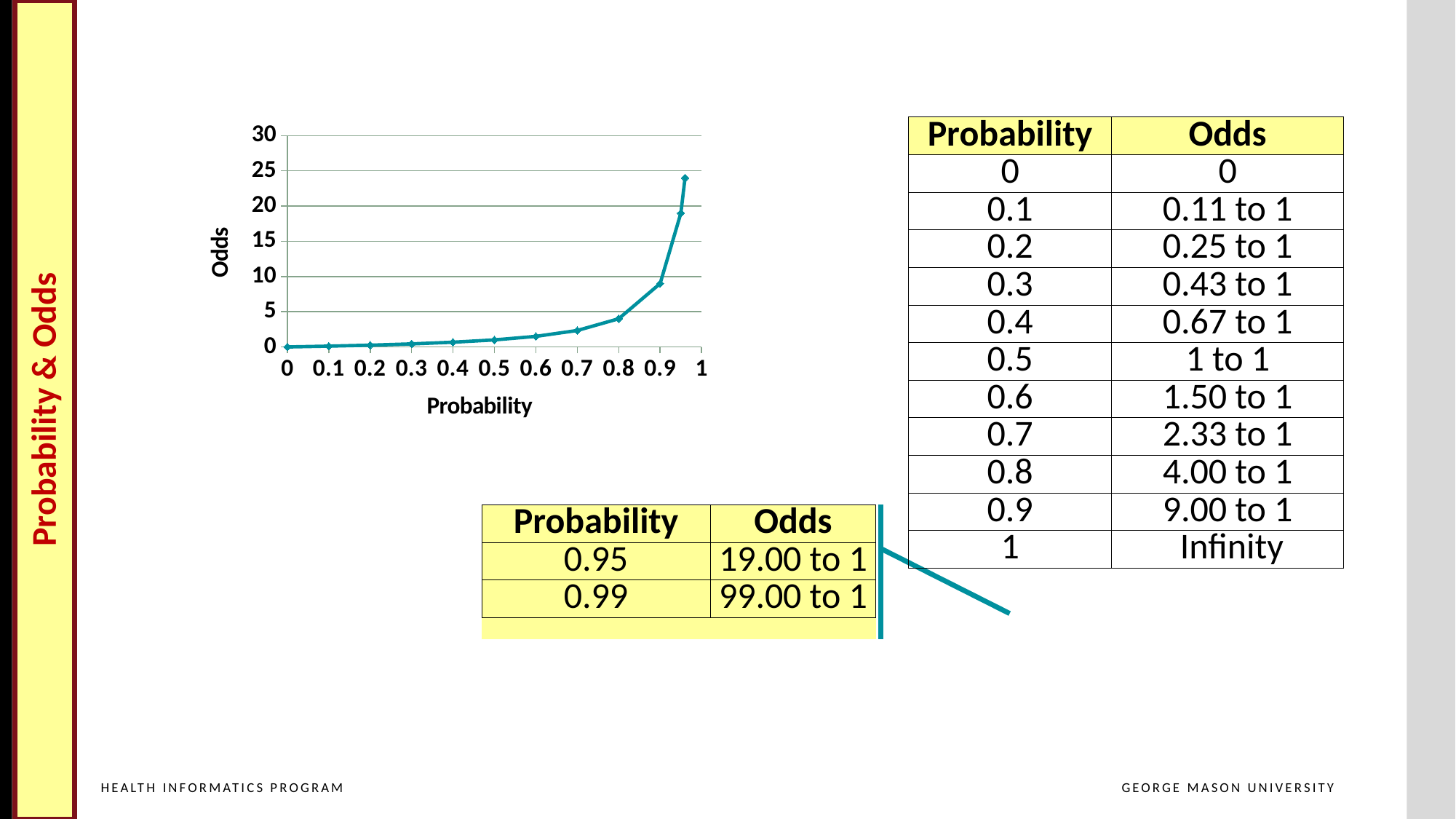
Which has the larger plotted odds value: probability 0.3 or probability 0.8? 0.8 Do the odds values rise or fall as probability increases along the x axis? rise What is the title of the y axis of the chart? Odds How many tick labels are shown on the x axis of the chart? 11 What is the highest tick value shown on the y axis of the chart? 30 Is the highest plotted point on the chart greater or less than 20? greater Is the odds value plotted at probability 0.9 greater or less than 5? greater Which has the larger plotted odds value: probability 0.8 or probability 0.9? 0.9 Is the odds value plotted at probability 0.5 greater or less than 5? less What is the odds value plotted at probability 0? 0 What kind of chart is shown on the slide? line chart